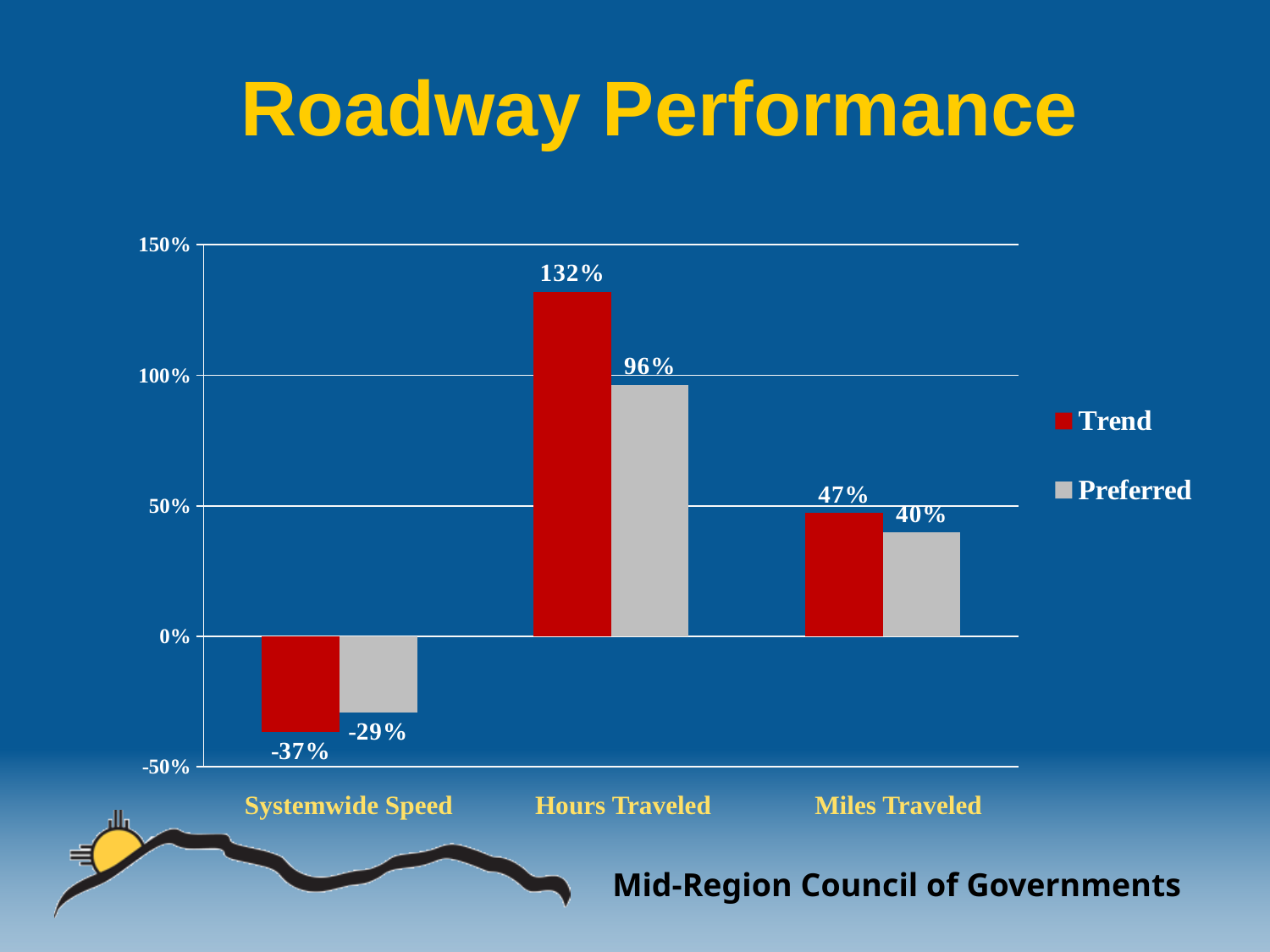
What kind of chart is shown on the slide? Bar chart What is the difference between the Trend and Preferred values for Hours Traveled? 36% How many categories are shown on the x axis? 3 Which category has the highest Trend value? Hours Traveled What is the difference between the Trend and Preferred values for Miles Traveled? 7% How many series does the legend list? 2 What is the Trend value for Hours Traveled? 132% What is the Preferred value for Systemwide Speed? -29% Which category has the lowest Preferred value? Systemwide Speed What is the Trend value for Systemwide Speed? -37% What is the Preferred value for Miles Traveled? 40% Which is larger for Hours Traveled, the Trend value or the Preferred value? Trend